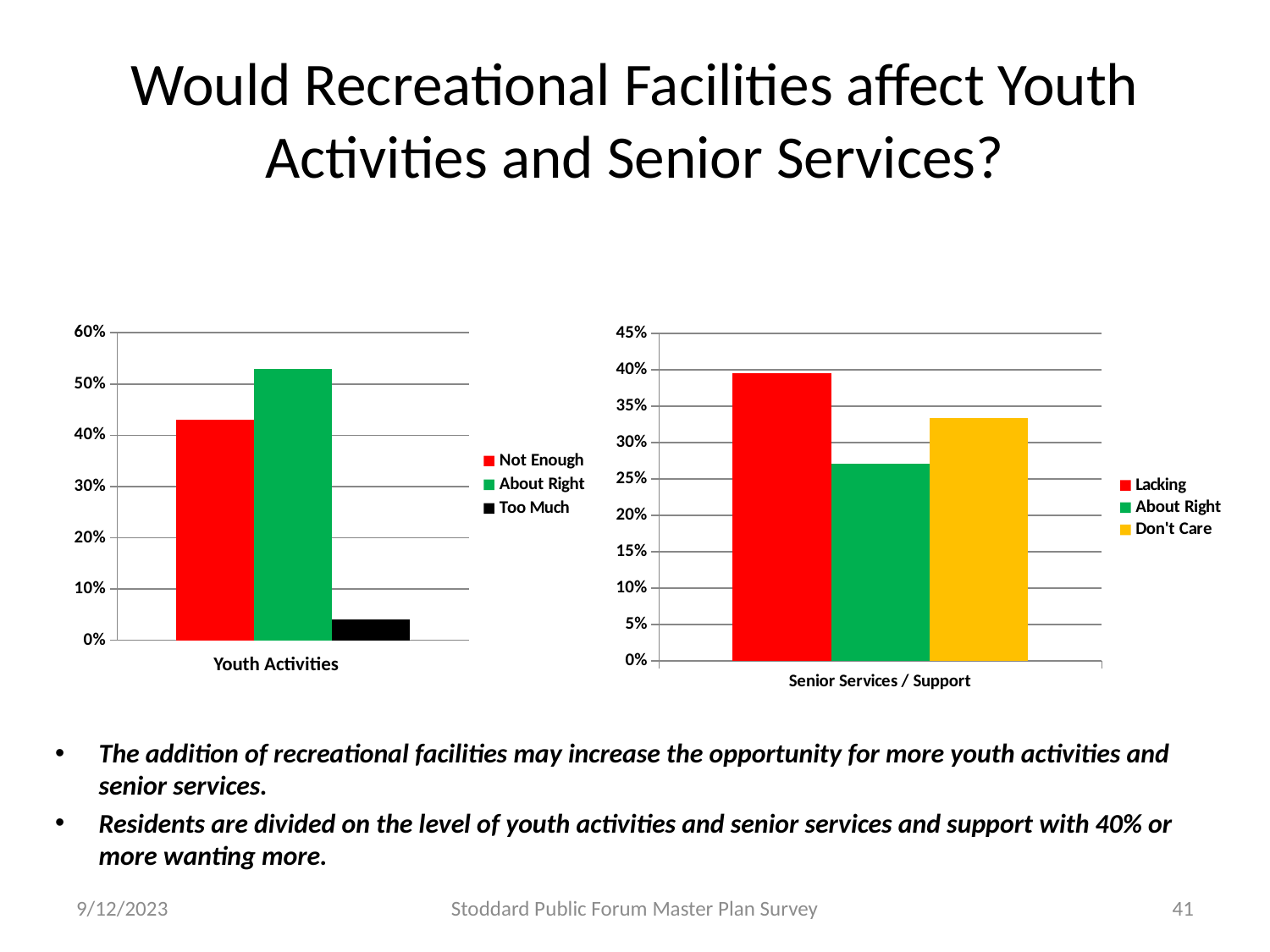
In the Youth Activities chart, how many series does the legend list? 3 In the Senior Services / Support chart, is the value for Lacking greater or less than 35%? greater In the Senior Services / Support chart, which is larger, Don't Care or About Right? Don't Care In the Youth Activities chart, which series has the lowest value? Too Much In the Youth Activities chart, is the value for Too Much greater or less than 10%? less What kind of chart is the Senior Services / Support chart? bar chart In the Senior Services / Support chart, which series has the lowest value? About Right In the Senior Services / Support chart, which series has the highest value? Lacking In the Youth Activities chart, which series has the highest value? About Right In the Youth Activities chart, is the value for About Right greater or less than 50%? greater